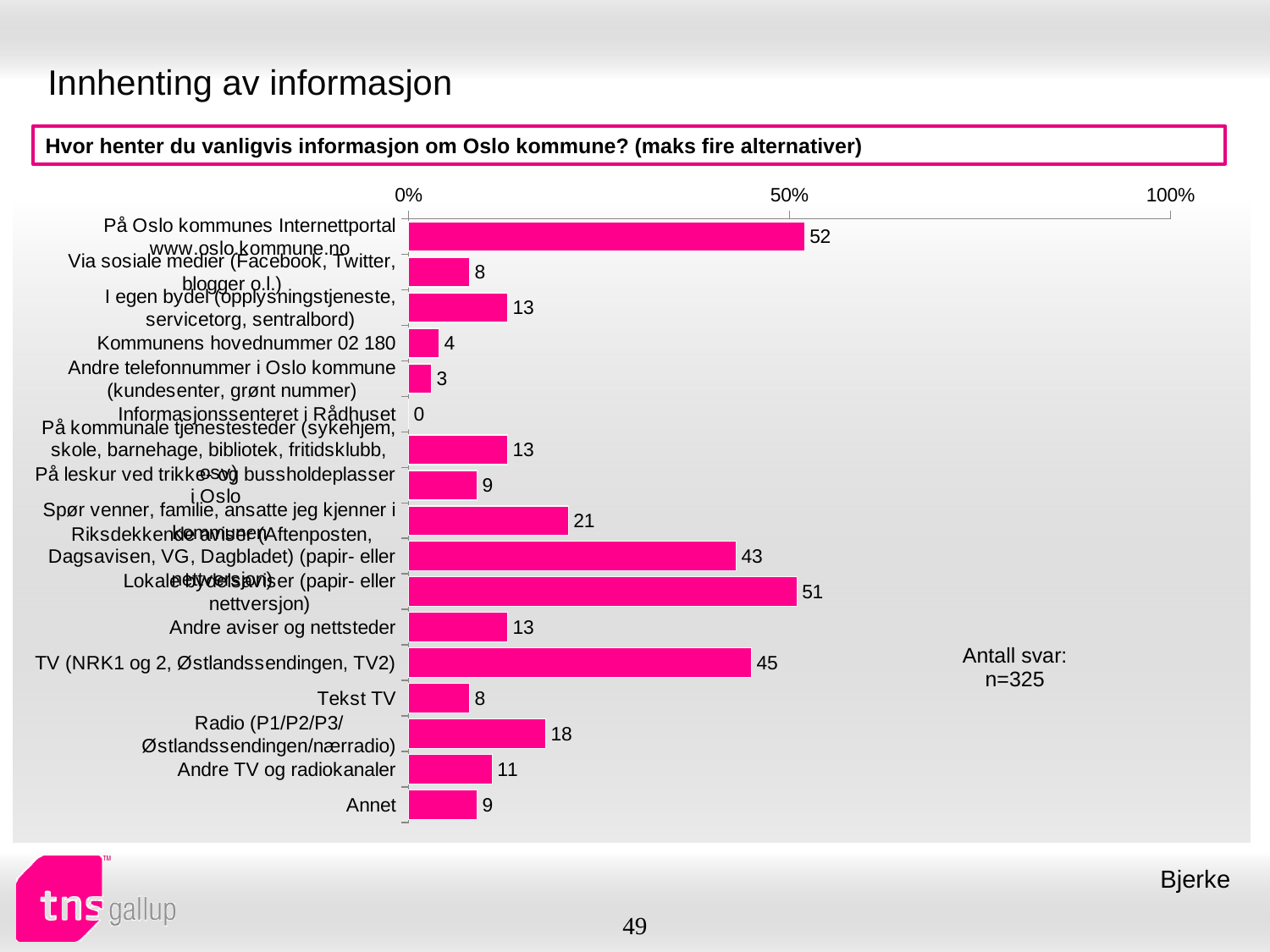
Is the value for "På Oslo kommunes Internettportal www.oslo.kommune.no" greater or less than 50%? greater Which category has the highest value? På Oslo kommunes Internettportal www.oslo.kommune.no What is the value for "TV (NRK1 og 2, Østlandssendingen, TV2)"? 45 What is the value for "Tekst TV"? 8 How many categories are shown in the chart? 17 What is the number of respondents (n) stated on the slide? n=325 What is the value for "Kommunens hovednummer 02 180"? 4 Which is larger, the value for "Andre TV og radiokanaler" or the value for "Andre aviser og nettsteder"? Andre aviser og nettsteder What is the value for "Annet"? 9 What is the difference between the values for "TV (NRK1 og 2, Østlandssendingen, TV2)" and "Radio (P1/P2/P3/Østlandssendingen/nærradio)"? 27 What kind of chart is shown on the slide? bar chart Which category has the lowest value? Informasjonssenteret i Rådhuset